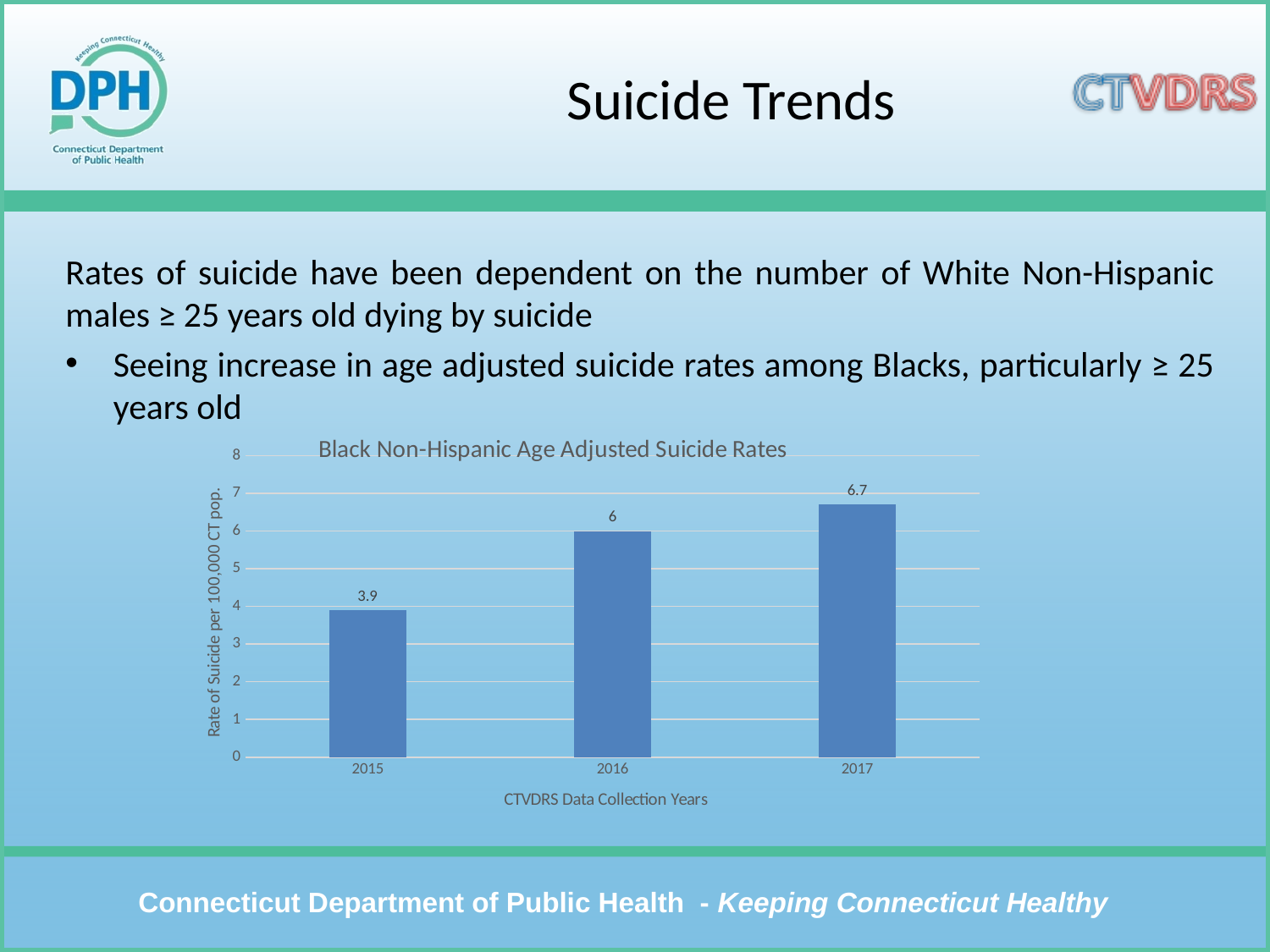
What is the difference between the suicide rates for 2016 and 2015? 2.1 What is the Black Non-Hispanic age adjusted suicide rate for 2017? 6.7 What is the Black Non-Hispanic age adjusted suicide rate for 2016? 6 Which year has a higher suicide rate, 2016 or 2017? 2017 Do the suicide rates rise or fall from 2015 to 2017? Rise What is the Black Non-Hispanic age adjusted suicide rate for 2015? 3.9 Which year has the highest Black Non-Hispanic age adjusted suicide rate? 2017 Which year has the lowest Black Non-Hispanic age adjusted suicide rate? 2015 How many years are shown on the x axis of the chart? 3 What is the difference between the suicide rates for 2017 and 2015? 2.8 What is the title of the chart? Black Non-Hispanic Age Adjusted Suicide Rates What kind of chart is shown on the slide? Bar chart